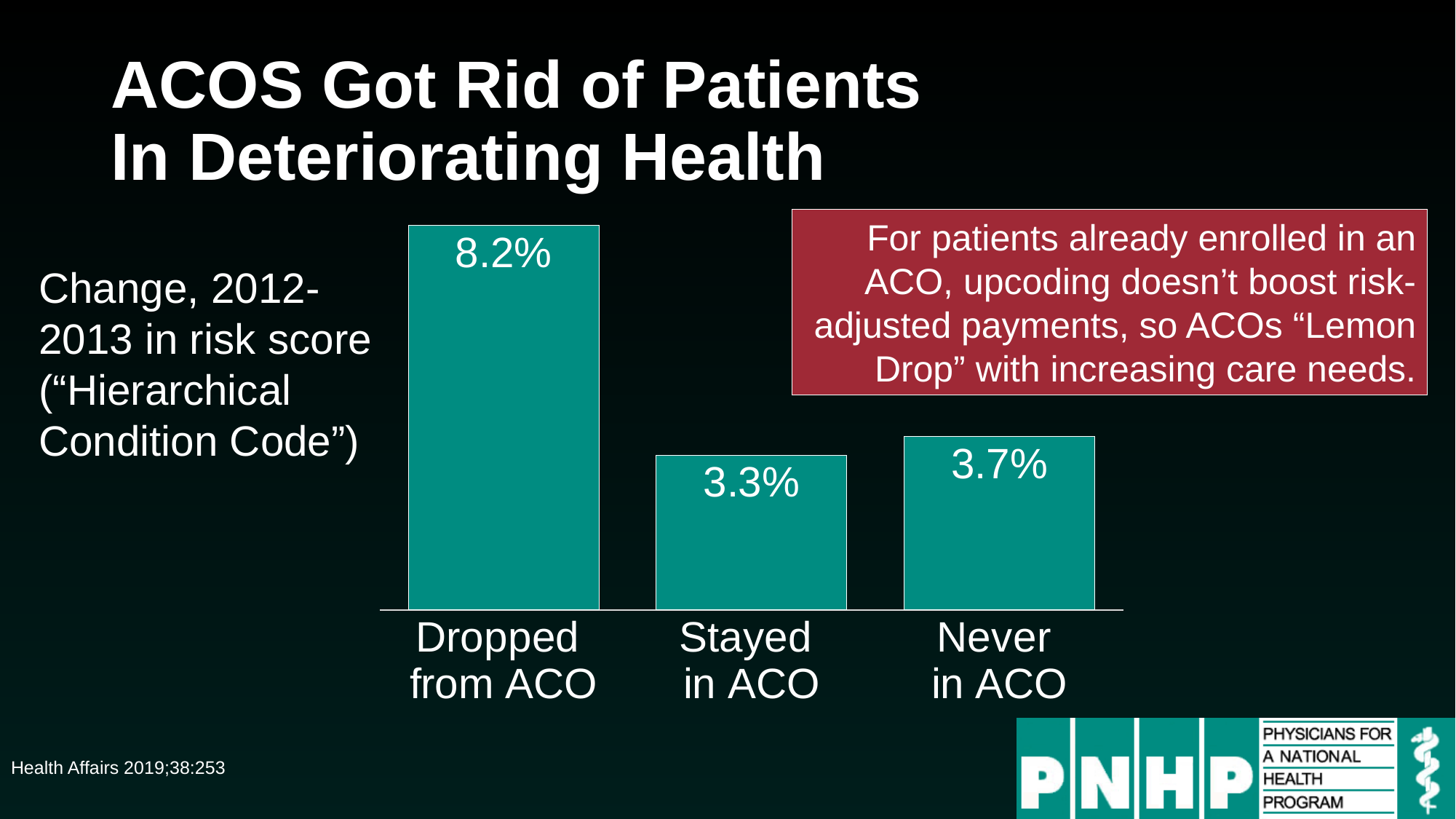
What kind of chart is shown on the slide? Bar chart What is the difference in risk score change between patients never in an ACO and patients who stayed in an ACO? 0.4% What is the change in risk score for patients who stayed in an ACO? 3.3% How many categories are shown in the chart? 3 What is the difference in risk score change between patients dropped from an ACO and patients who stayed in an ACO? 4.9% Which is larger: the risk score change for patients never in an ACO or for patients who stayed in an ACO? Never in ACO Which category has the lowest change in risk score? Stayed in ACO What measure does the chart show, according to the text to its left? Change, 2012-2013 in risk score ("Hierarchical Condition Code") Which category has the highest change in risk score? Dropped from ACO What is the change in risk score for patients who were dropped from an ACO? 8.2% What colour are the bars in the chart? Teal What is the change in risk score for patients never in an ACO? 3.7%